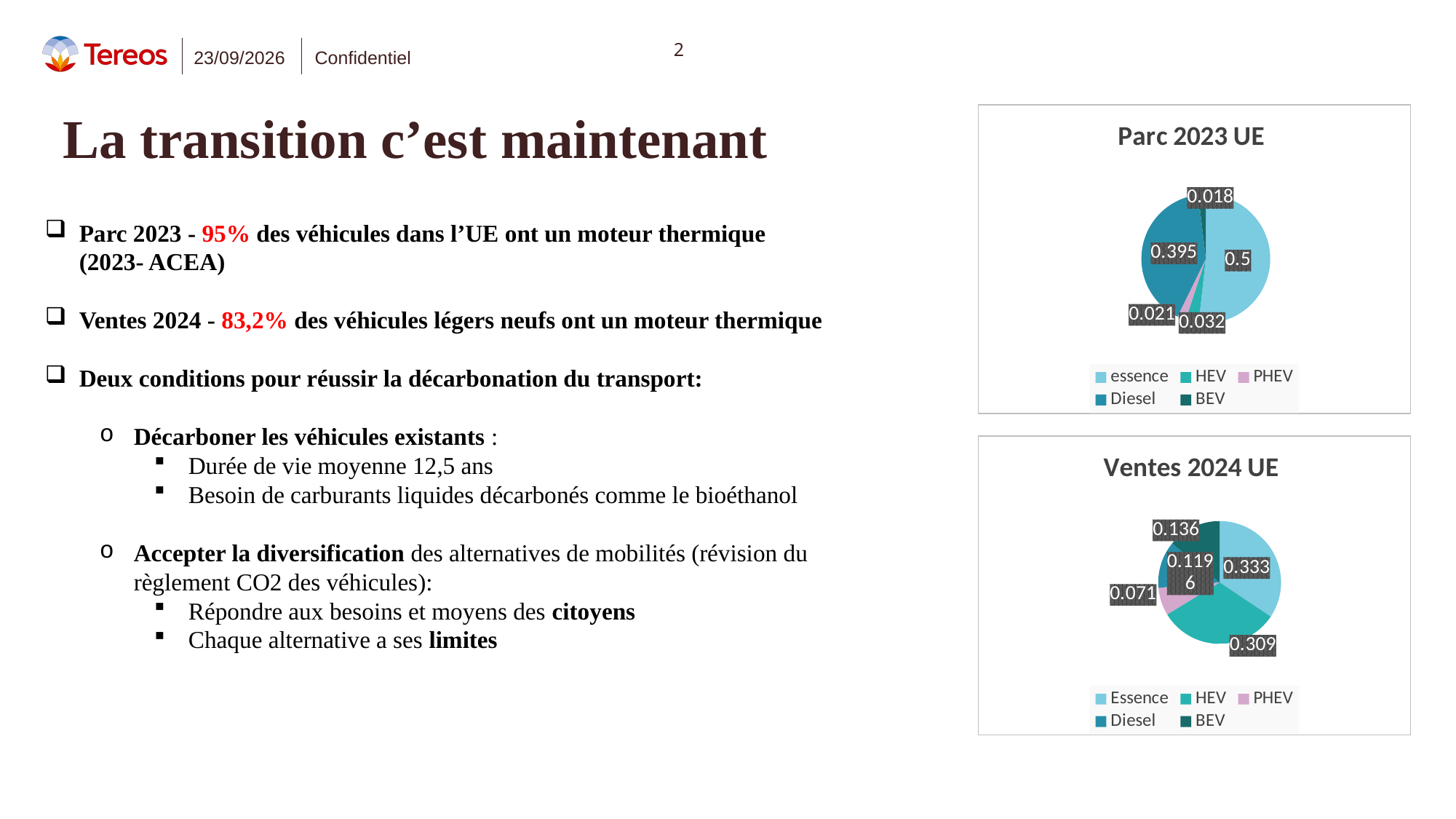
In the "Ventes 2024 UE" chart, which is larger, the value for BEV or the value for PHEV? BEV In the "Ventes 2024 UE" chart, what is the value for Essence? 0.333 In the "Parc 2023 UE" chart, which category has the largest slice? essence In the "Ventes 2024 UE" chart, what is the value for HEV? 0.309 How many categories does the legend of the "Parc 2023 UE" chart list? 5 In the "Parc 2023 UE" chart, what is the difference between the essence and Diesel values? 0.105 What kind of chart is the "Parc 2023 UE" chart? pie chart In the "Parc 2023 UE" chart, what is the value for Diesel? 0.395 In the "Parc 2023 UE" chart, what is the value for BEV? 0.018 In the "Parc 2023 UE" chart, what is the value for essence? 0.5 In the "Parc 2023 UE" chart, which category has the smallest slice? BEV In the "Ventes 2024 UE" chart, which category has the smallest slice? PHEV